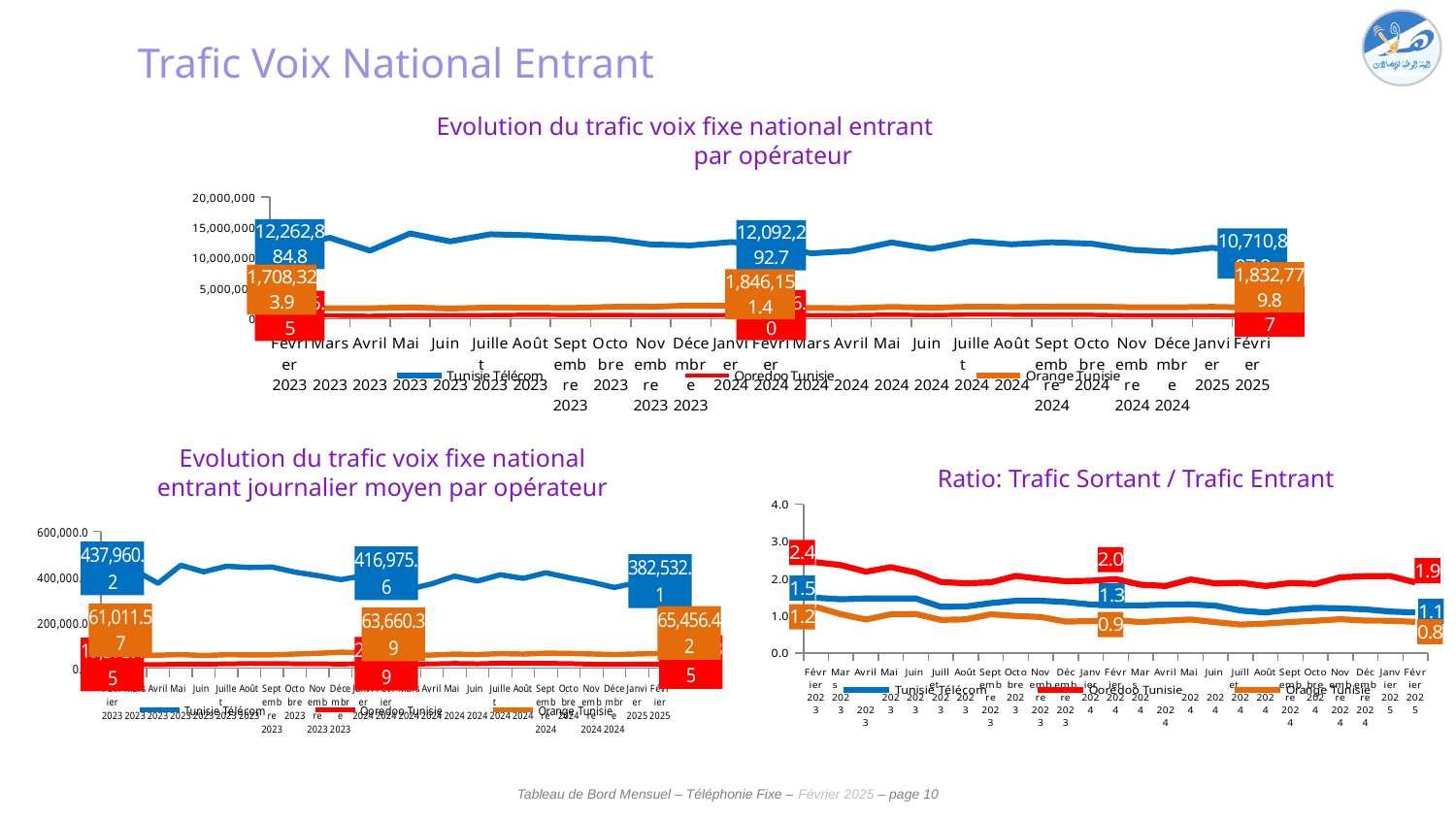
In the chart 'Evolution du trafic voix fixe national entrant par opérateur', what is the value for Orange Tunisie in Février 2025? 1,832,779.8 In the chart 'Evolution du trafic voix fixe national entrant journalier moyen par opérateur', what is the value for Tunisie Télécom in Février 2025? 382,532.1 In the chart 'Ratio: Trafic Sortant / Trafic Entrant', what is the ratio for Orange Tunisie in Février 2024? 0.9 In the chart 'Ratio: Trafic Sortant / Trafic Entrant', what is the ratio for Tunisie Télécom in Février 2025? 1.1 In the chart 'Evolution du trafic voix fixe national entrant par opérateur', what is the value for Tunisie Télécom in Février 2024? 12,092,292.7 In the chart 'Ratio: Trafic Sortant / Trafic Entrant', which operator has the highest ratio in Février 2025? Ooredoo Tunisie How many series does the legend of the chart 'Evolution du trafic voix fixe national entrant par opérateur' list? 3 In the chart 'Ratio: Trafic Sortant / Trafic Entrant', what is the ratio for Ooredoo Tunisie in Février 2023? 2.4 In the chart 'Evolution du trafic voix fixe national entrant par opérateur', is the value for Tunisie Télécom in Février 2025 greater or less than 5,000,000? greater What kind of chart is 'Ratio: Trafic Sortant / Trafic Entrant'? line chart In the chart 'Ratio: Trafic Sortant / Trafic Entrant', does the Ooredoo Tunisie ratio rise or fall from Février 2023 to Février 2025? fall In the chart 'Ratio: Trafic Sortant / Trafic Entrant', by how much did the Ooredoo Tunisie ratio change between Février 2023 (2.4) and Février 2025 (1.9)? 0.5